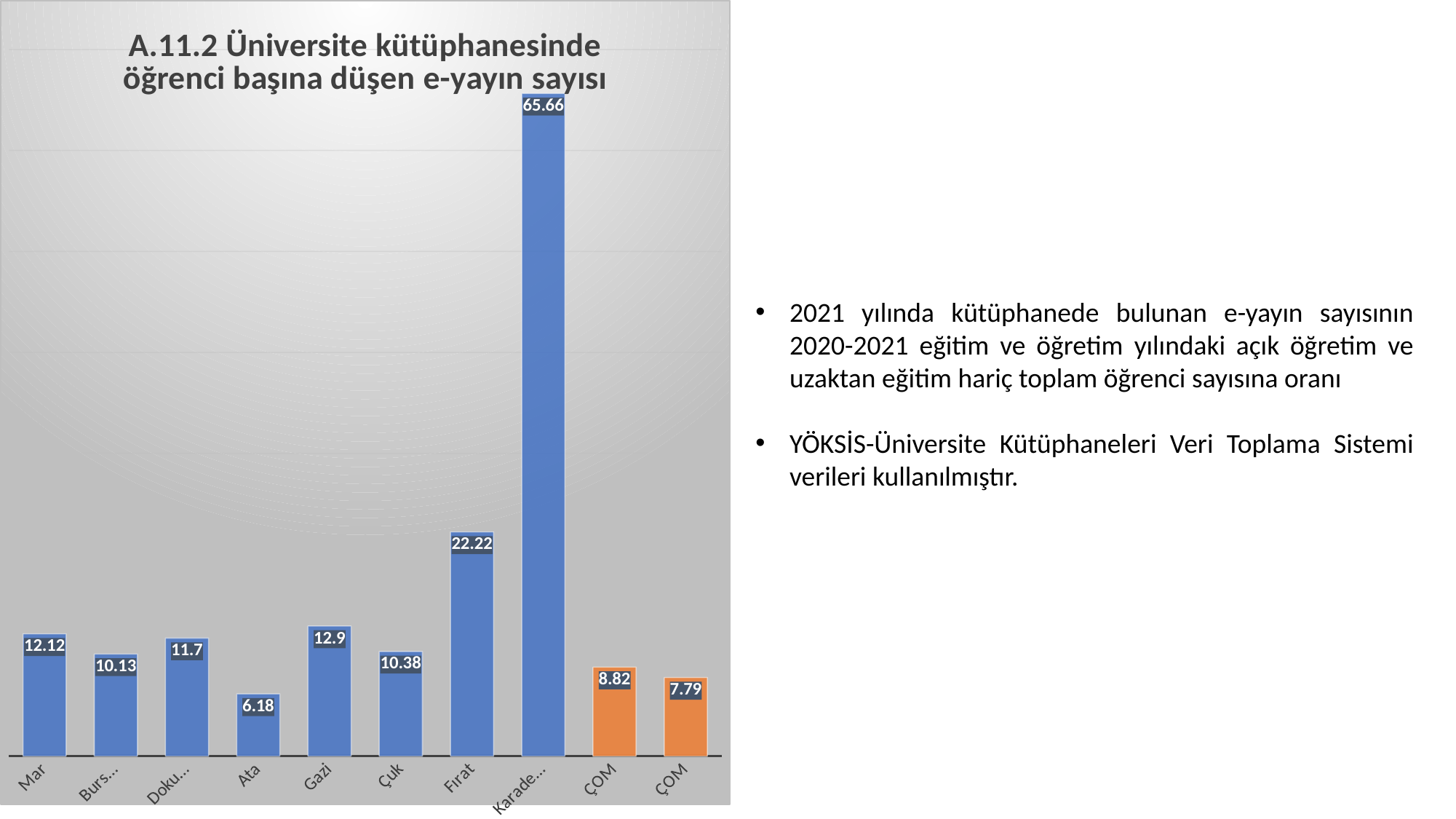
What is the difference between the values for Fırat and Gazi? 9.32 How many bars are coloured orange? 2 Which category has the lowest value? Ata Which is larger, the value for Mar or the value for Çuk? Mar What is the value for Gazi? 12.9 What is the highest value shown in the chart? 65.66 What is the value for Çuk? 10.38 What is the value for Mar? 12.12 What is the value for Ata? 6.18 How many bars are shown in the chart? 10 What type of chart is shown on the slide? bar chart What is the value for Fırat? 22.22